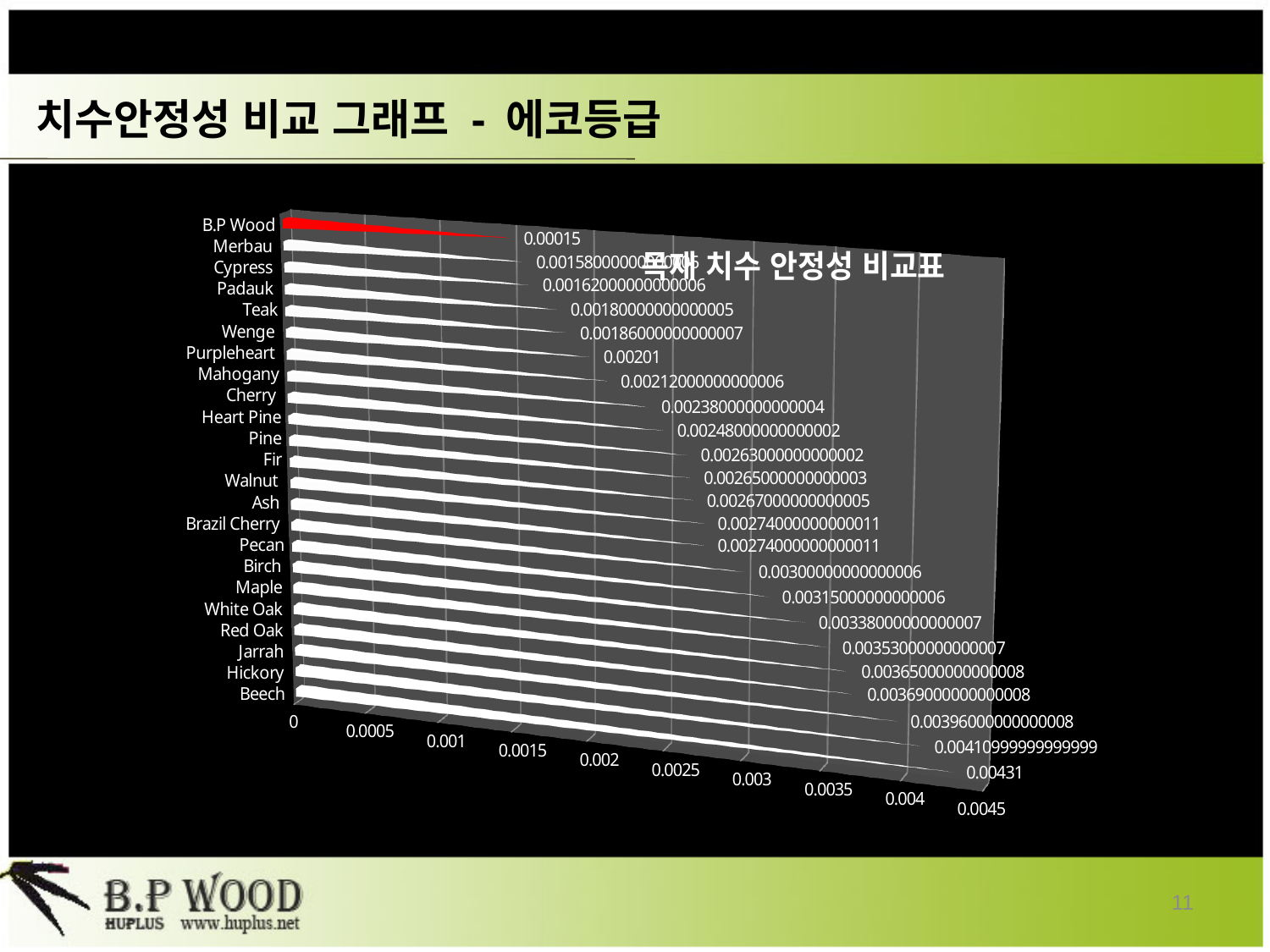
What is the title of the chart? 목재 치수 안정성 비교표 Which wood species has the lowest value in the chart? B.P Wood Which has a larger value, Beech or Hickory? Beech Which wood species has the highest value in the chart? Beech Which bar is coloured red rather than white? B.P Wood What kind of chart is shown on the slide? bar chart How many wood species (categories) are plotted in the chart? 23 What is the difference between the values for Beech and B.P Wood? 0.00416 Is the value for Beech greater or less than 0.004? greater What is the value shown for Wenge? 0.00201 What is the value shown for Beech? 0.00431 What is the value shown for B.P Wood? 0.00015